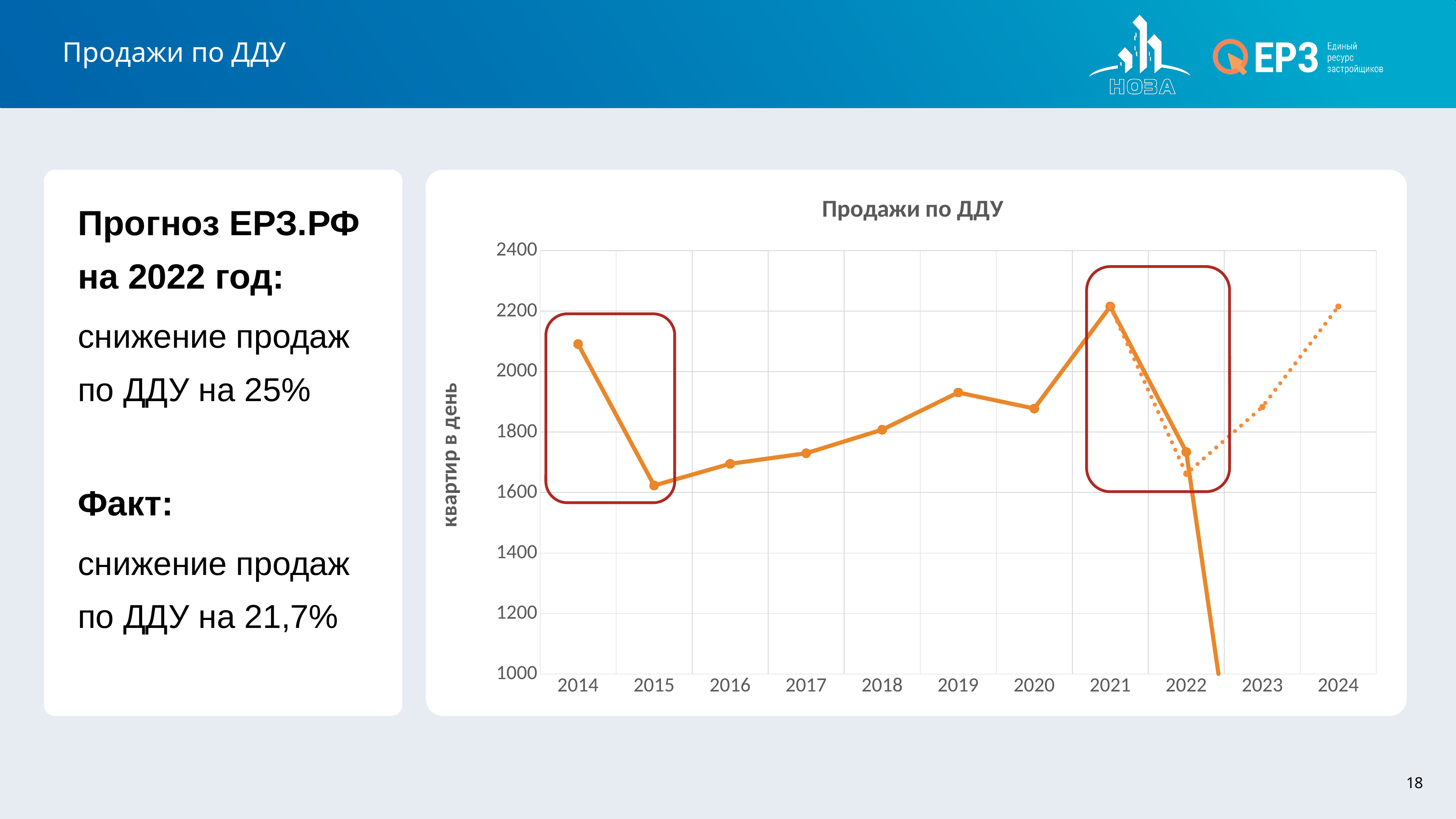
How many years are labelled on the x axis of the chart? 11 Is the value for 2014 greater or less than 2000? greater Which is larger, the value for 2019 or the value for 2020? 2019 What kind of chart is shown on the slide? Line chart Is the value for 2019 greater or less than 2000? less Do the values rise or fall along the x axis from 2015 to 2019? Rise Is the value for 2015 greater or less than 1800? less What is the label of the vertical axis of the chart? квартир в день What is the title of the chart? Продажи по ДДУ Which year has the highest marked point on the solid line? 2021